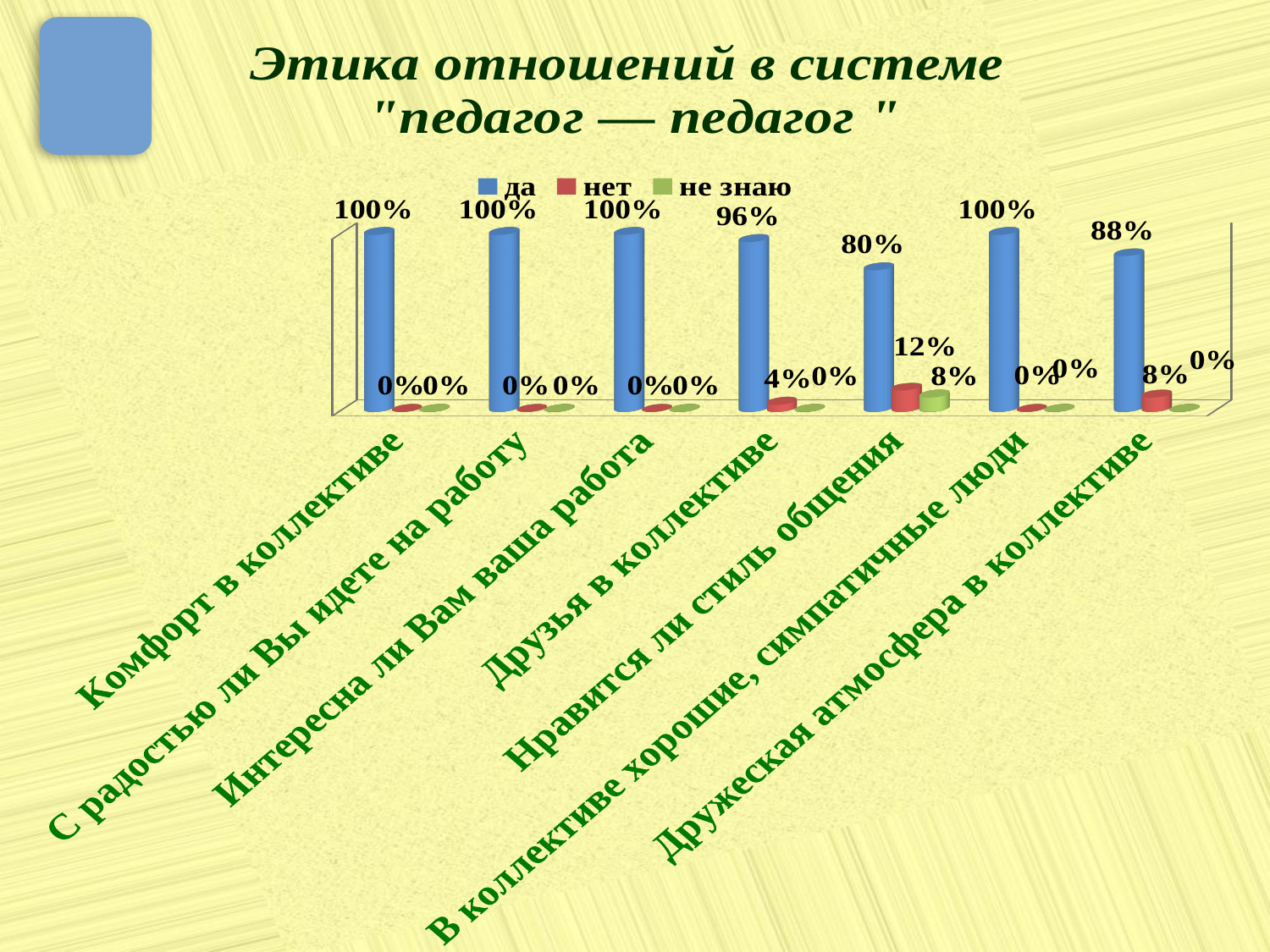
Which category has the lowest value in the "да" series? Нравится ли стиль общения How many categories are shown on the x axis of the chart? 7 What is the value of the "да" series for "Дружеская атмосфера в коллективе"? 88% Which is larger: the "да" value for "Дружеская атмосфера в коллективе" or for "Друзья в коллективе"? Друзья в коллективе Which category has the highest value in the "нет" series? Нравится ли стиль общения What is the value of the "нет" series for "Нравится ли стиль общения"? 12% How many series does the legend list? 3 What is the value of the "не знаю" series for "Нравится ли стиль общения"? 8% What kind of chart is shown on the slide? Bar chart What is the value of the "нет" series for "Дружеская атмосфера в коллективе"? 8% What is the difference between the "да" values for "Друзья в коллективе" and "Нравится ли стиль общения"? 16% What is the value of the "да" series for "Друзья в коллективе"? 96%